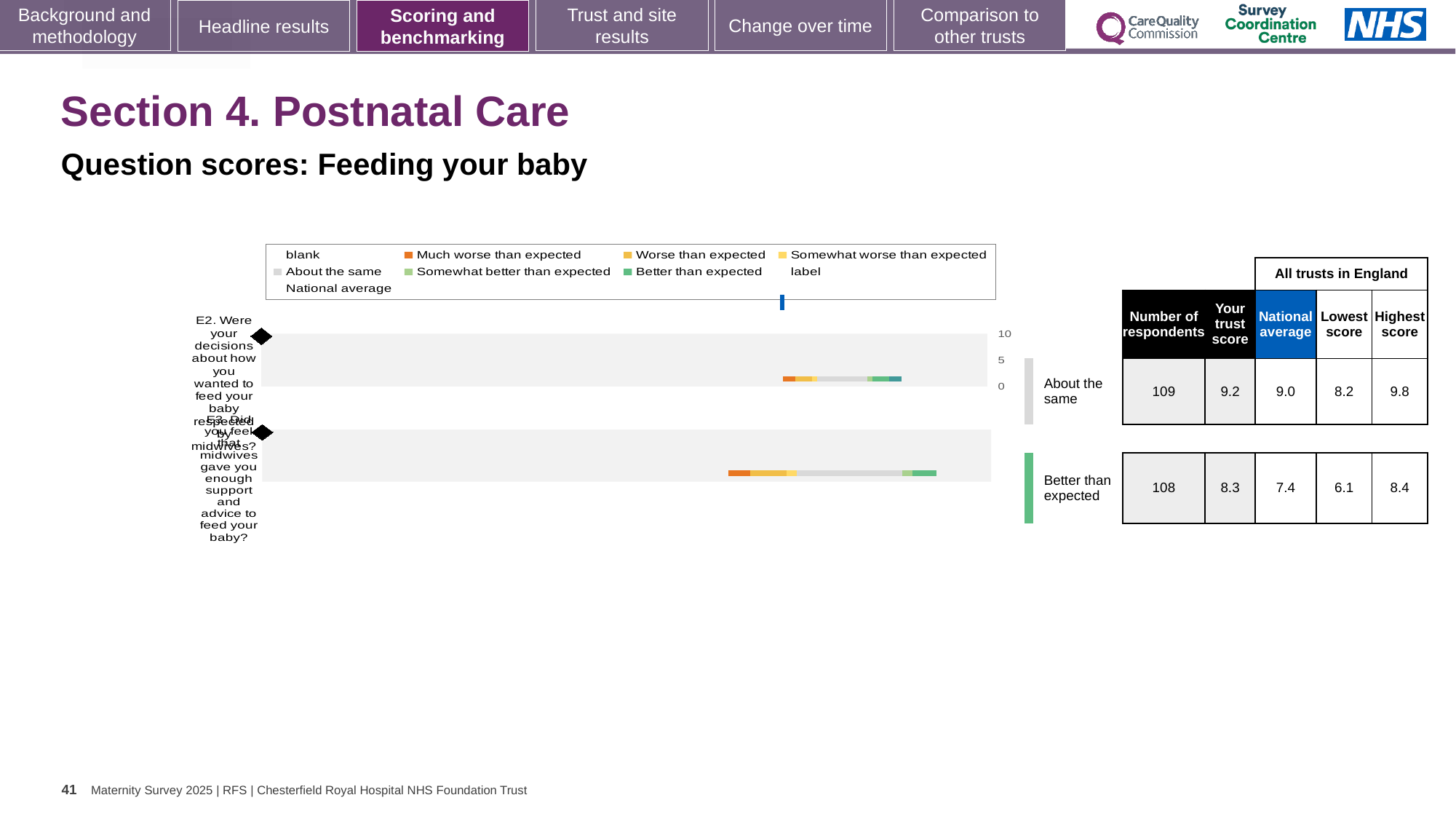
What is the title of the slide's chart section? Question scores: Feeding your baby In the table beside the chart, what is the national average for question E3 (midwives gave you enough support and advice to feed your baby)? 7.4 How many questions (categories) are plotted on the chart? 2 What kind of chart is shown on the slide? Bar chart In the table beside the chart, what is the trust score for question E2 (decisions about how you wanted to feed your baby respected by midwives)? 9.2 Which legend entry is shown in dark orange? Much worse than expected In the table beside the chart, what is the highest score across all trusts in England for question E3? 8.4 In the table beside the chart, how many respondents answered question E2? 109 For question E2, what is the difference between the highest score and the lowest score across all trusts in England? 1.6 Which benchmark category is shown for question E3 on the chart? Better than expected For question E3, which is larger: the trust score or the national average? Trust score For question E3, what is the difference between the trust score and the national average? 0.9